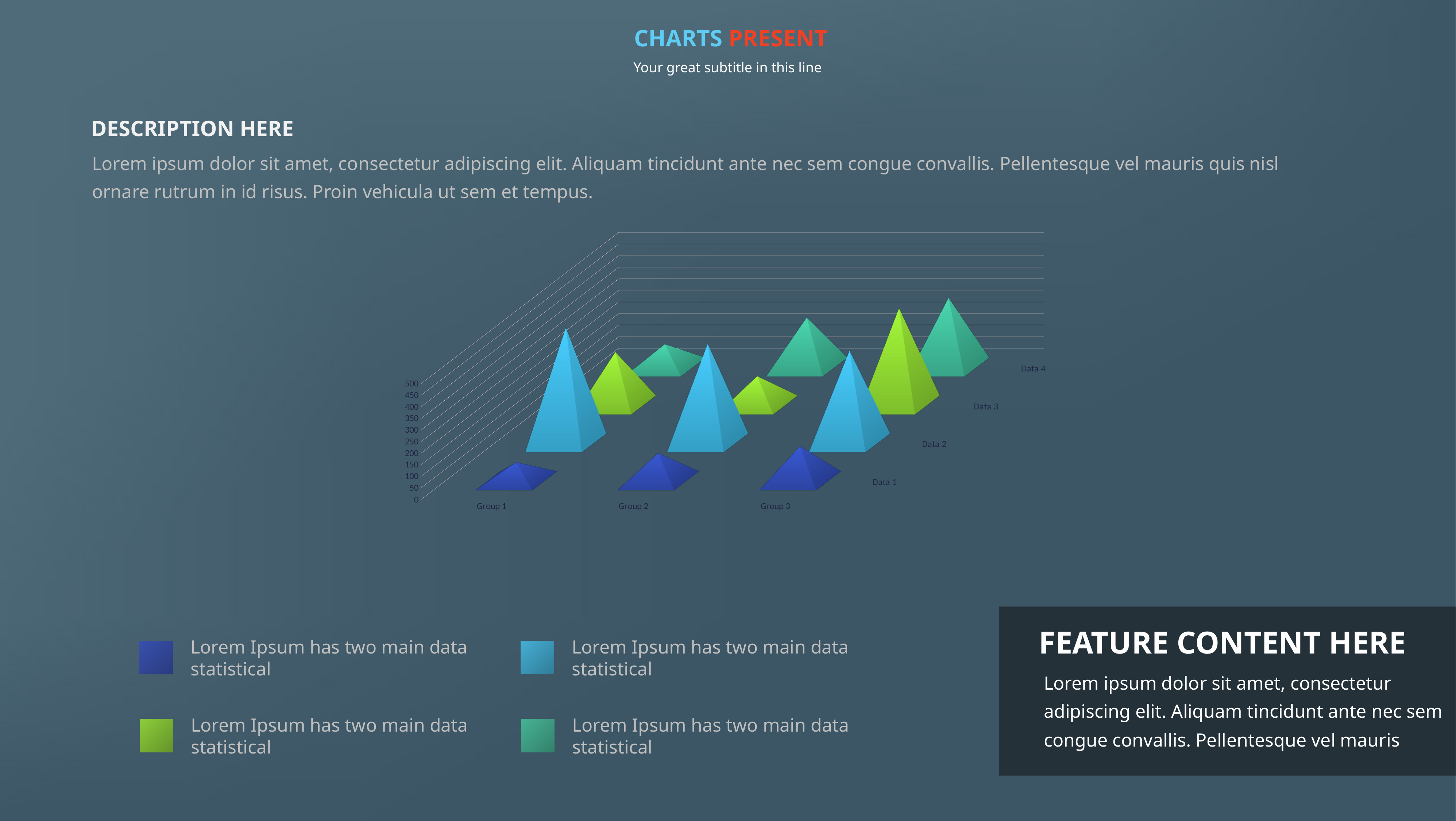
Which group has the highest value for Data 4? Group 3 Which group has the highest value for Data 3? Group 3 Do the values for Data 4 rise or fall from Group 1 to Group 3? rise How many data series does the chart plot? 4 How many groups are shown along the x axis of the chart? 3 Which series has the lowest values in every group? Data 1 What is the highest value shown on the chart's vertical axis? 500 Is the value for Data 2 in Group 1 greater or less than 200? greater In Group 1, which is larger: Data 2 or Data 1? Data 2 Is the value for Data 1 in Group 2 greater or less than 200? less In Group 3, which is larger: Data 4 or Data 1? Data 4 What kind of chart is shown on the slide? bar chart